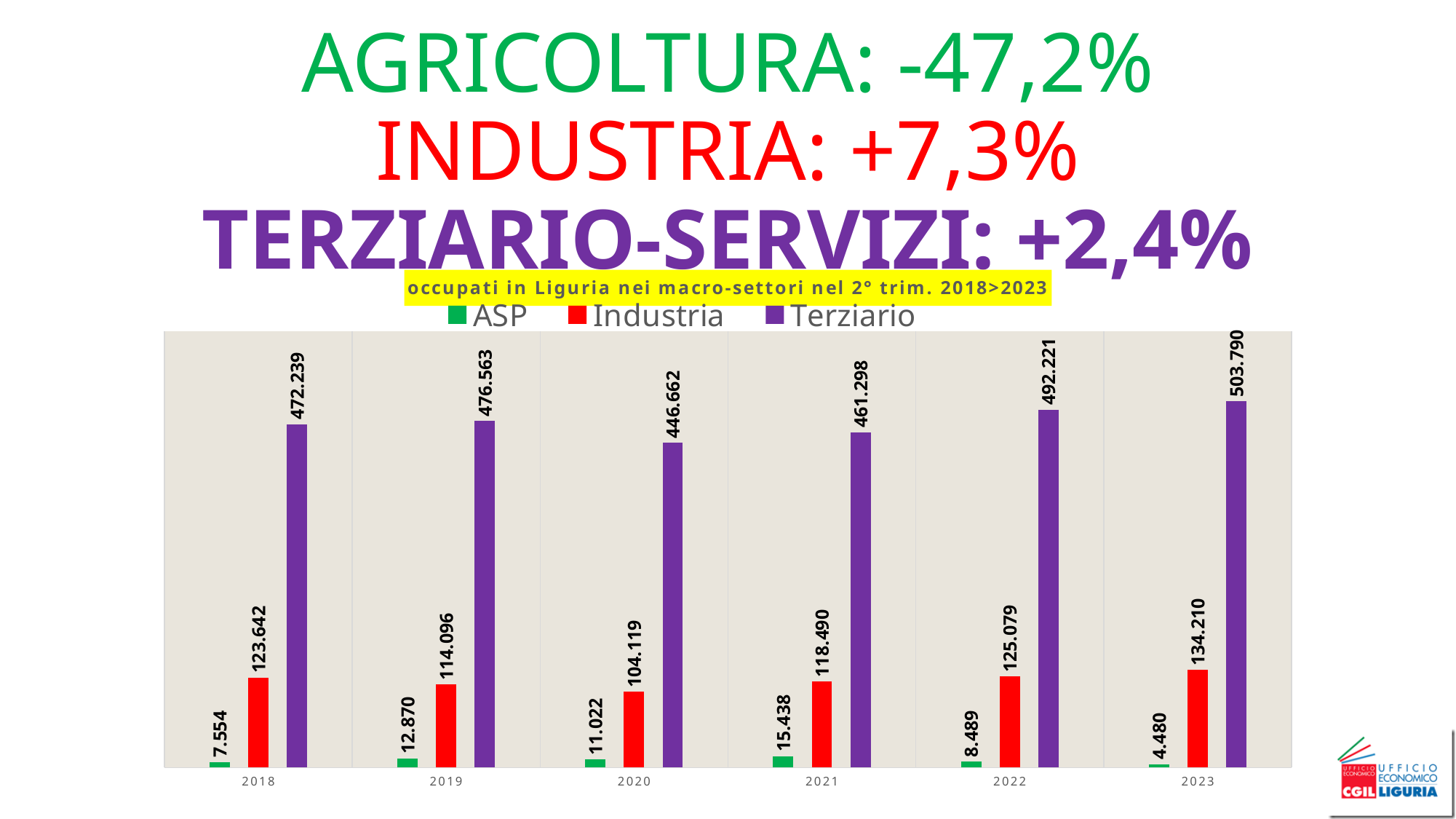
Does the Industria value rise or fall from 2020 to 2023? rise In which year is the ASP value highest? 2021 What is the title of the chart? occupati in Liguria nei macro-settori nel 2° trim. 2018>2023 What is the value for Industria in 2020? 104.119 What is the difference between the Terziario values in 2023 and 2018? 31.551 How many years are shown on the x axis of the chart? 6 In which year is the Terziario value lowest? 2020 What type of chart is shown on the slide? bar chart How many series does the chart legend list? 3 What is the value for Terziario in 2023? 503.790 What is the value for ASP in 2018? 7.554 Which is larger, the Industria value in 2019 or in 2021? 2021